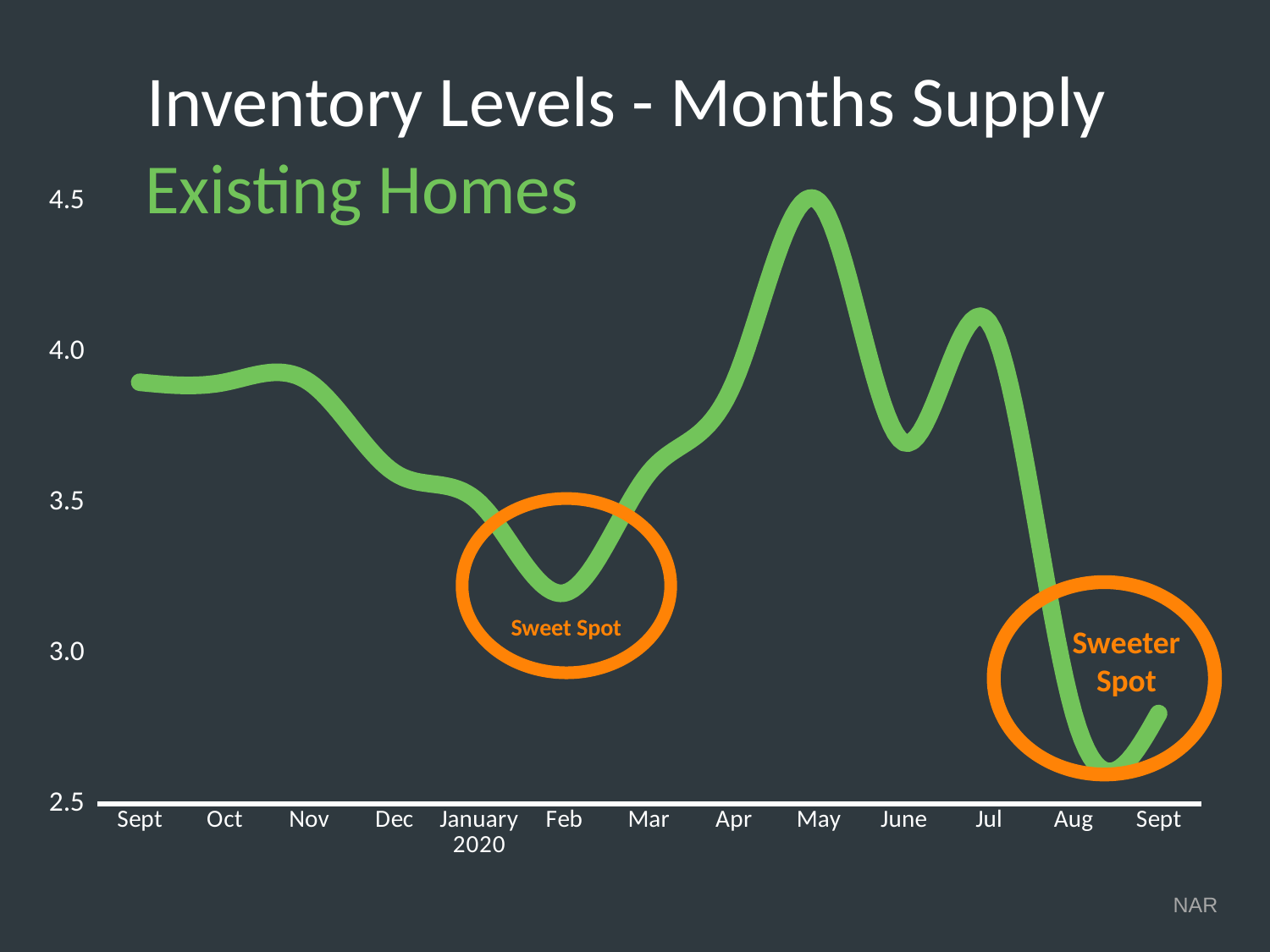
Which is larger, the value for Feb or the value for Aug? Feb What label is written inside the orange circle around the Feb dip? Sweet Spot What is the title of the chart? Inventory Levels - Months Supply Which is larger, the value for May or the value for Jul? May How many months are plotted along the x axis? 13 Is the value for Aug greater or less than 3.0? less Which month has the highest months supply of existing homes? May Is the value for Jul greater or less than 4.0? greater What kind of chart is shown on the slide? line chart Is the value for May greater or less than 4.0? greater